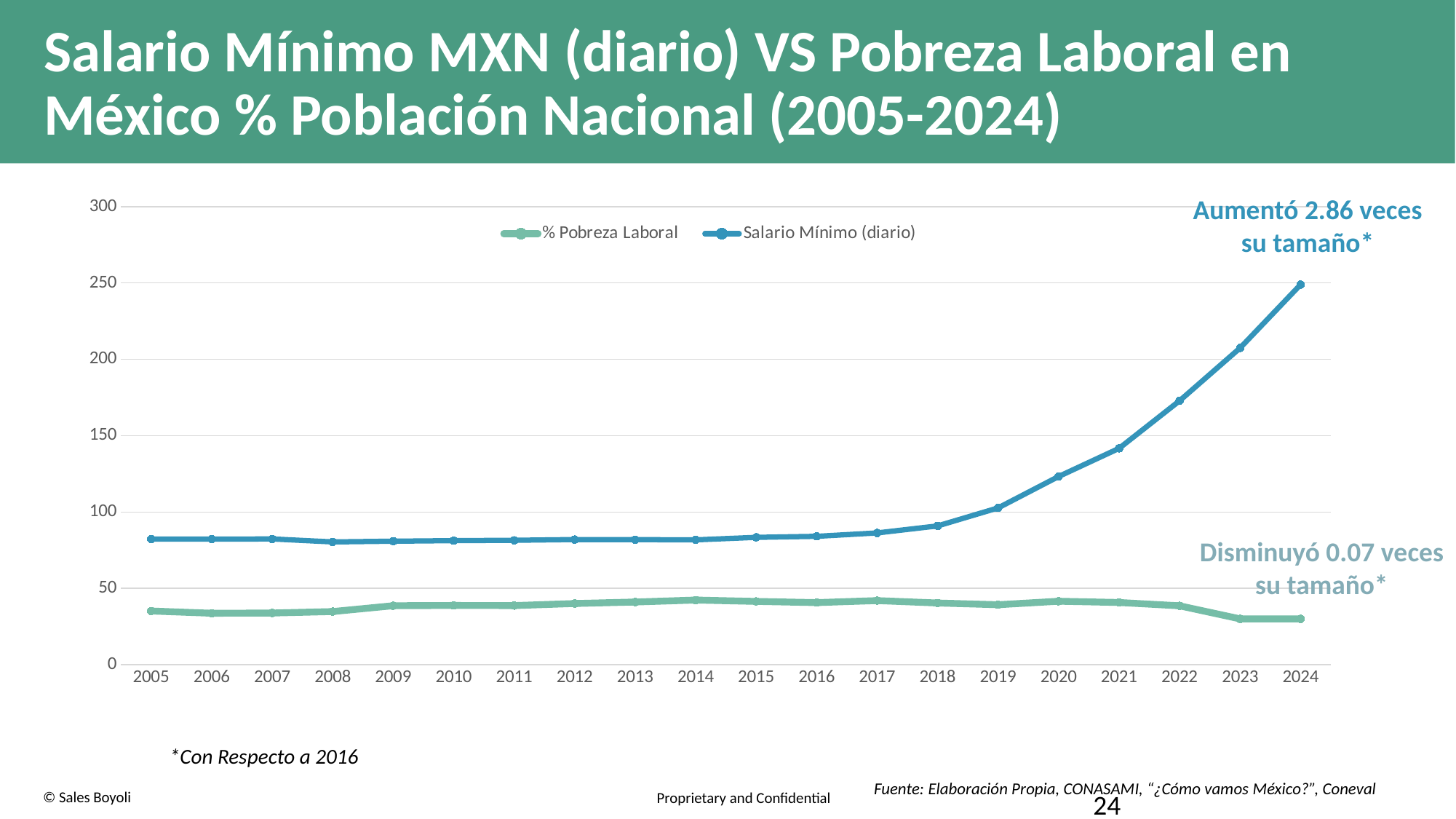
Which series has the larger value in 2016, % Pobreza Laboral or Salario Mínimo (diario)? Salario Mínimo (diario) According to the annotation on the chart, by how many times did the Salario Mínimo increase in size? 2.86 veces Is the value for Salario Mínimo (diario) in 2021 greater or less than 150? less Is the value for % Pobreza Laboral in 2024 greater or less than 50? less Is the value for Salario Mínimo (diario) in 2024 greater or less than 200? greater Does the % Pobreza Laboral series rise or fall from 2021 to 2024? fall Does the Salario Mínimo (diario) series rise or fall from 2016 to 2024? rise Which year has the highest value for Salario Mínimo (diario)? 2024 How many series does the legend list? 2 How many years are plotted along the x axis? 20 What kind of chart is shown on the slide? line chart